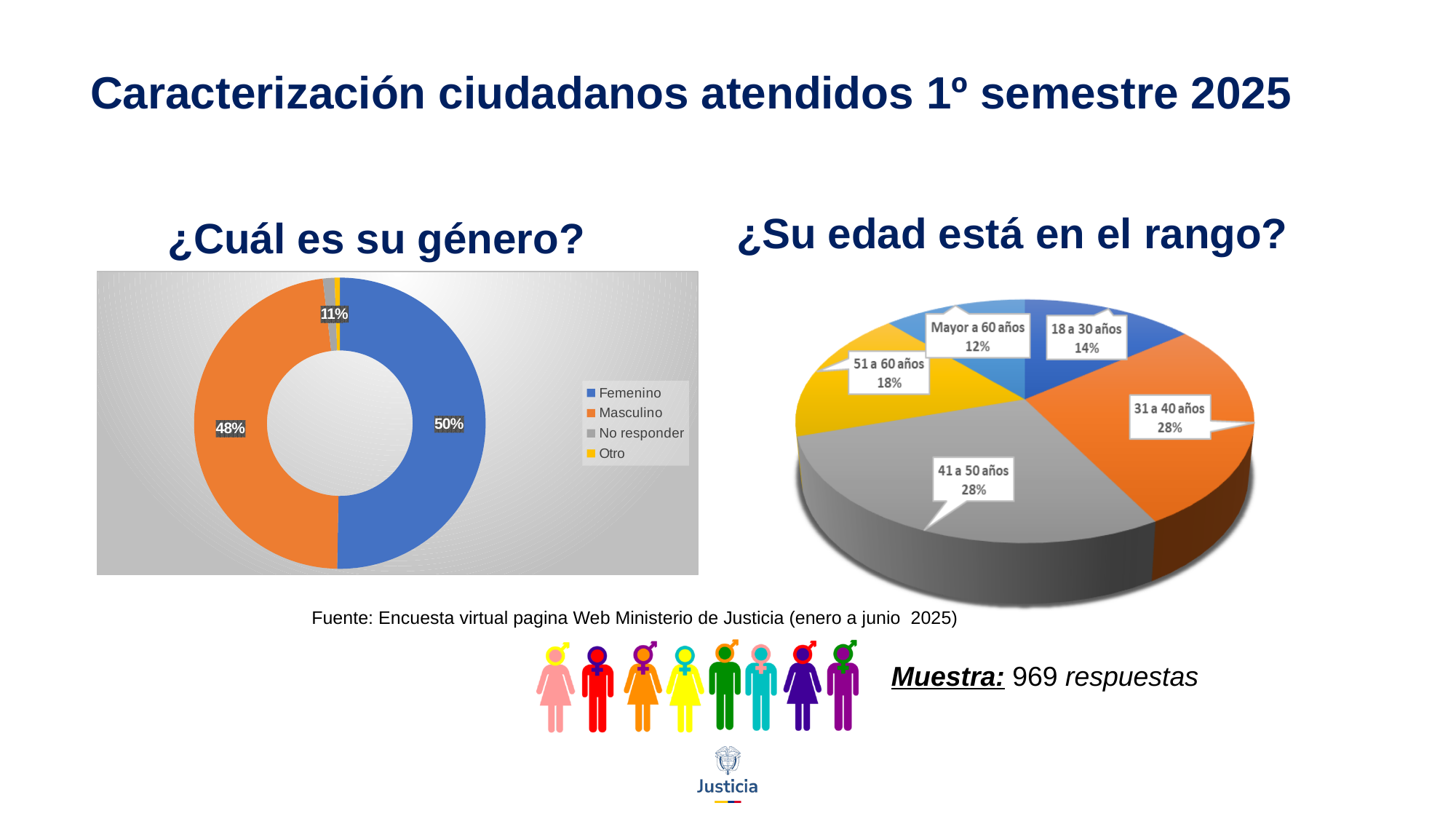
In the chart titled "¿Cuál es su género?", which category has the largest share? Femenino In the chart titled "¿Su edad está en el rango?", what percentage is shown for 51 a 60 años? 18% In the chart titled "¿Cuál es su género?", how many entries does the legend list? 4 In the chart titled "¿Su edad está en el rango?", what percentage is shown for 18 a 30 años? 14% In the chart titled "¿Su edad está en el rango?", which is larger: 51 a 60 años or 18 a 30 años? 51 a 60 años In the chart titled "¿Su edad está en el rango?", which age range has the smallest share? Mayor a 60 años In the chart titled "¿Cuál es su género?", what percentage is shown for Masculino? 48% In the chart titled "¿Su edad está en el rango?", how many age ranges are shown? 5 In the chart titled "¿Cuál es su género?", what percentage is shown for Femenino? 50% In the chart titled "¿Cuál es su género?", what colour represents Masculino? Orange In the chart titled "¿Cuál es su género?", what is the difference between the Femenino and Masculino percentages? 2% What kind of chart is the one titled "¿Su edad está en el rango?"? Pie chart